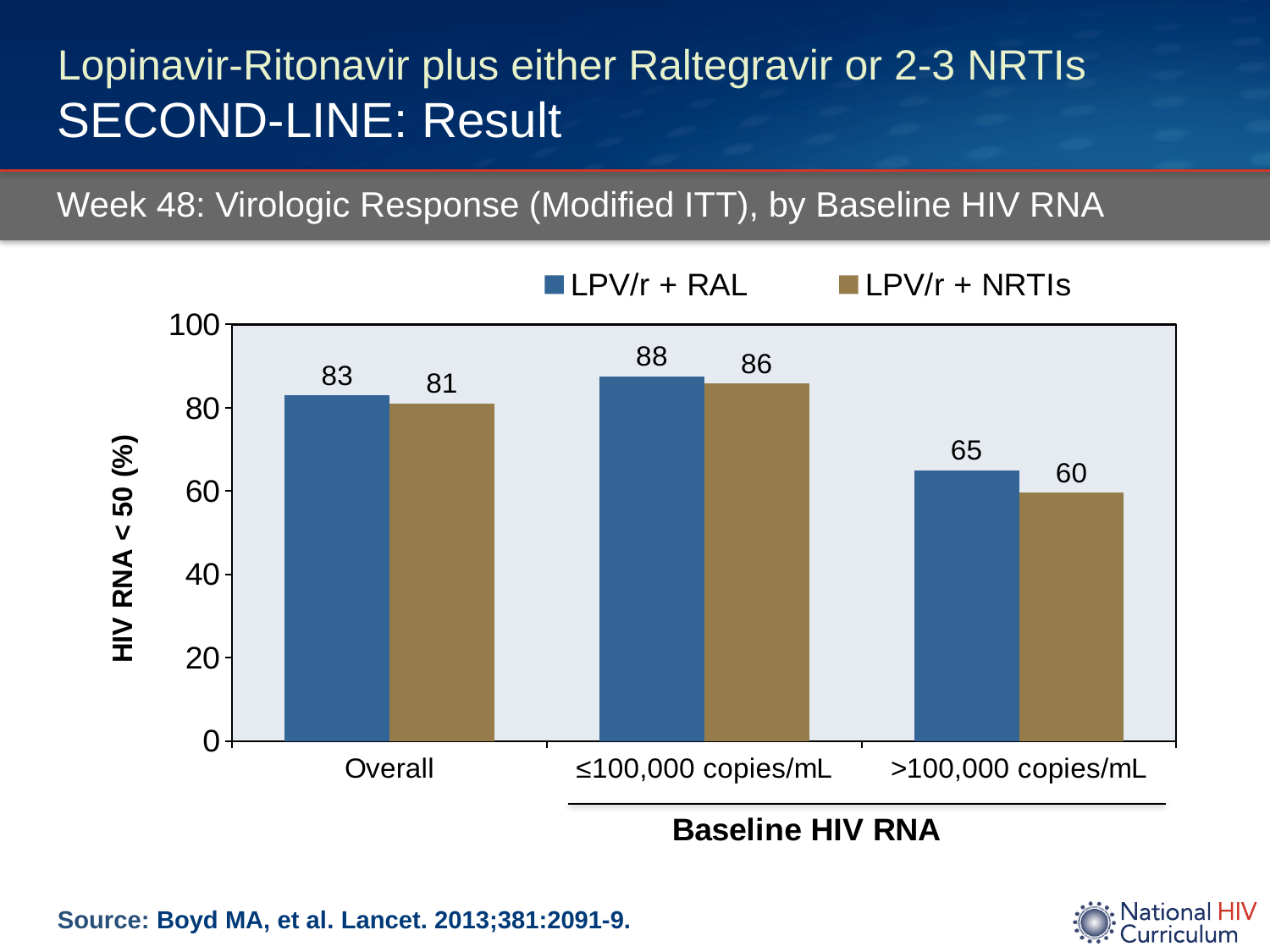
How many categories are shown on the x axis? 3 Which category has the lowest value for LPV/r + NRTIs? >100,000 copies/mL Which is larger in the Overall category, LPV/r + RAL or LPV/r + NRTIs? LPV/r + RAL What is the difference between LPV/r + RAL and LPV/r + NRTIs in the >100,000 copies/mL category? 5 What is the value for LPV/r + NRTIs in the >100,000 copies/mL category? 60 What kind of chart is shown on the slide? Bar chart Is the value for LPV/r + RAL in the >100,000 copies/mL category greater or less than 80? less What is the label of the y axis? HIV RNA < 50 (%) What is the value for LPV/r + RAL in the Overall category? 83 What is the value for LPV/r + NRTIs in the ≤100,000 copies/mL category? 86 Which category has the highest value for LPV/r + RAL? ≤100,000 copies/mL How many series does the legend list? 2